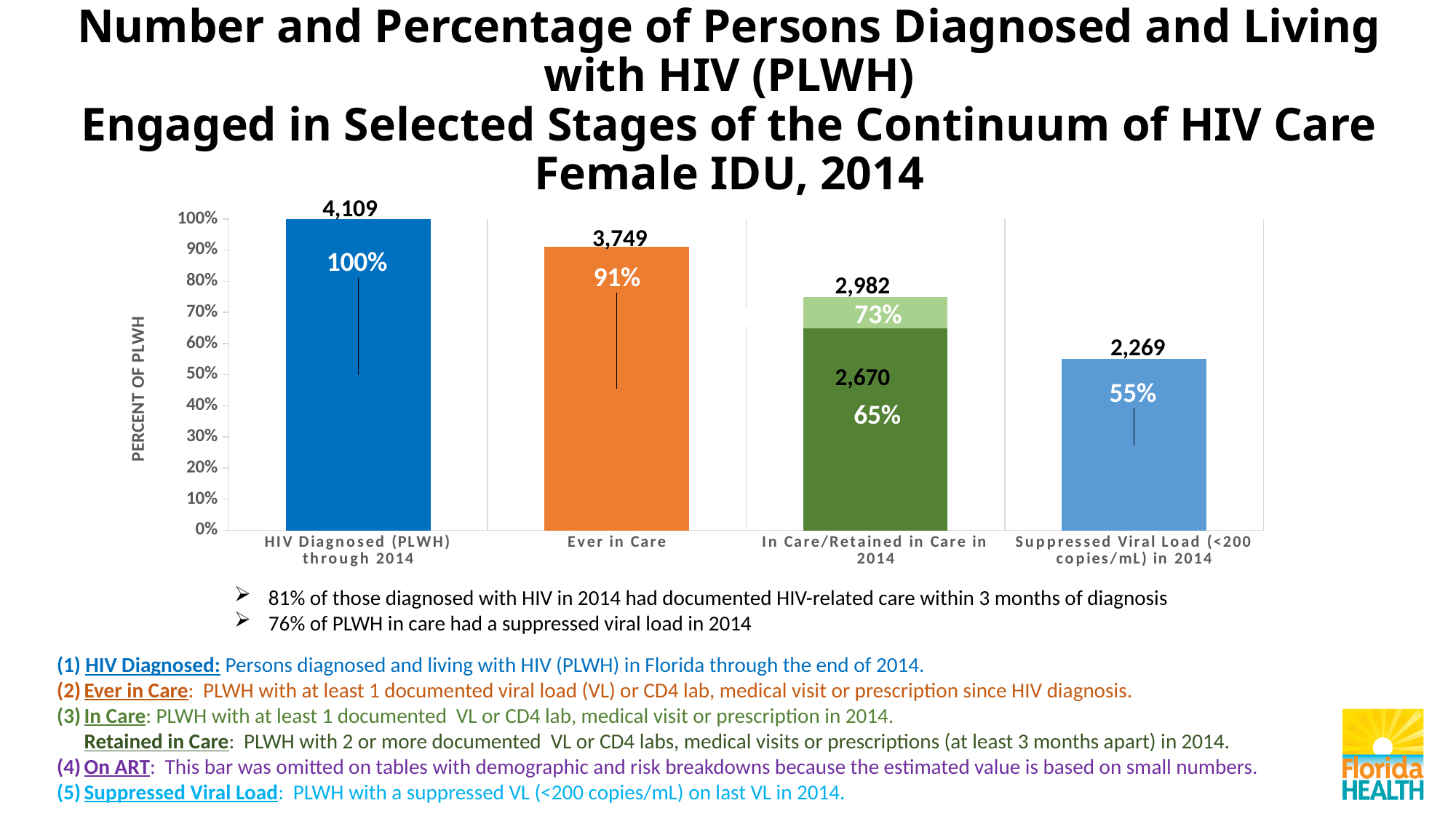
What number is printed for the 'Retained in Care' (dark green) portion of the 'In Care/Retained in Care in 2014' bar? 2,670 What percentage is shown for the light green 'In Care' portion of the 'In Care/Retained in Care in 2014' bar? 73% Which is larger: the percentage for 'Ever in Care' or the percentage for 'Suppressed Viral Load (<200 copies/mL) in 2014'? Ever in Care How many categories are shown on the x axis of the chart? 4 Which category has the highest number of persons? HIV Diagnosed (PLWH) through 2014 Which category has the lowest percentage of PLWH? Suppressed Viral Load (<200 copies/mL) in 2014 What percentage is shown for 'Suppressed Viral Load (<200 copies/mL) in 2014'? 55% What number is printed above the 'HIV Diagnosed (PLWH) through 2014' bar? 4,109 What percentage is shown for 'Ever in Care'? 91% What number is printed above the 'Ever in Care' bar? 3,749 What type of chart is shown on the slide? Bar chart What is the difference in number of persons between 'HIV Diagnosed (PLWH) through 2014' and 'Ever in Care'? 360